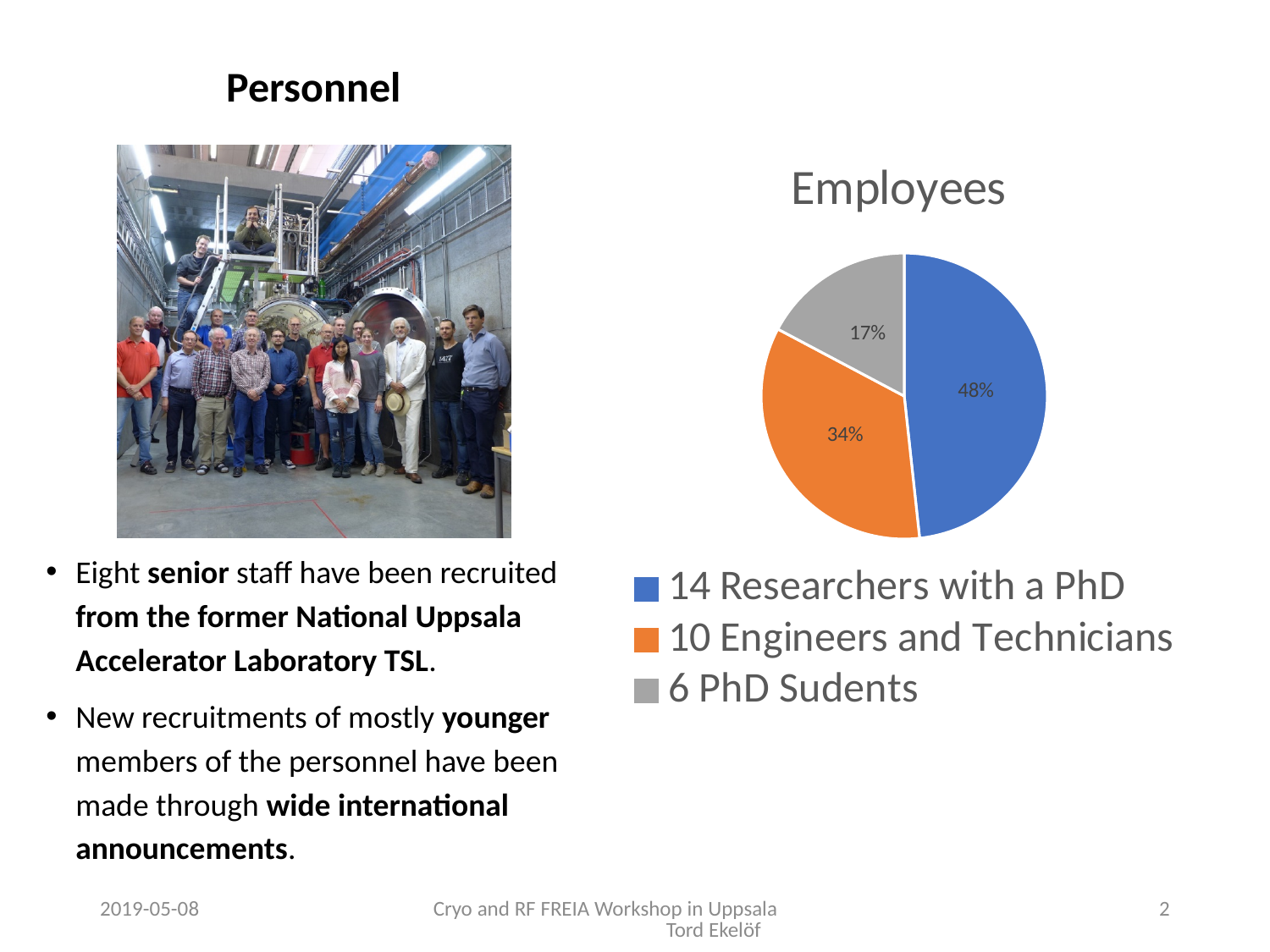
What is the difference in percentage points between the Researchers with a PhD slice and the Engineers and Technicians slice? 14 What percentage of employees are PhD Students? 17% What percentage of employees are Researchers with a PhD? 48% What colour is the slice for Engineers and Technicians? orange What type of chart is shown on the slide? pie chart How many categories does the pie chart have? 3 Which category has the smallest share of the pie? 6 PhD Sudents Which category has the largest share of the pie? 14 Researchers with a PhD What is the title of the chart? Employees How many Researchers with a PhD are listed in the legend? 14 What percentage of employees are Engineers and Technicians? 34% Which is larger: the share for Engineers and Technicians or the share for PhD Students? Engineers and Technicians